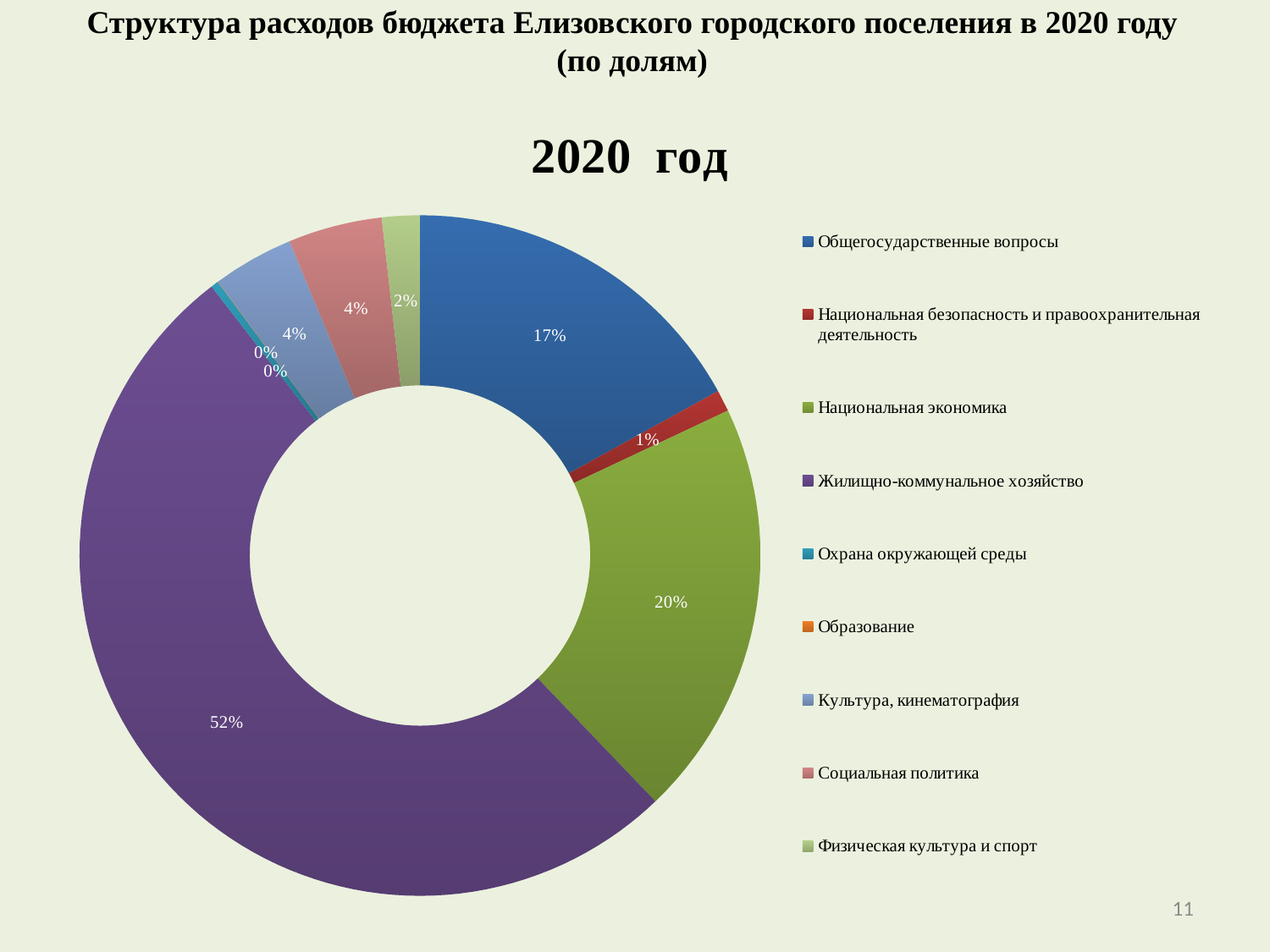
What is the title shown above the chart? 2020 год How many categories does the legend list? 9 What is the difference in percentage points between Национальная экономика and Общегосударственные вопросы? 3 What kind of chart is shown on the slide? Doughnut (pie) chart What is the value for Физическая культура и спорт? 2% What share of the chart does Жилищно-коммунальное хозяйство account for? 52% Which category has the largest share of the chart? Жилищно-коммунальное хозяйство What is the value for Национальная безопасность и правоохранительная деятельность? 1% Which is larger, the share for Социальная политика or the share for Физическая культура и спорт? Социальная политика What percentage is shown for Общегосударственные вопросы? 17% What is the value shown for Национальная экономика? 20% What colour is the segment for Национальная экономика? Green